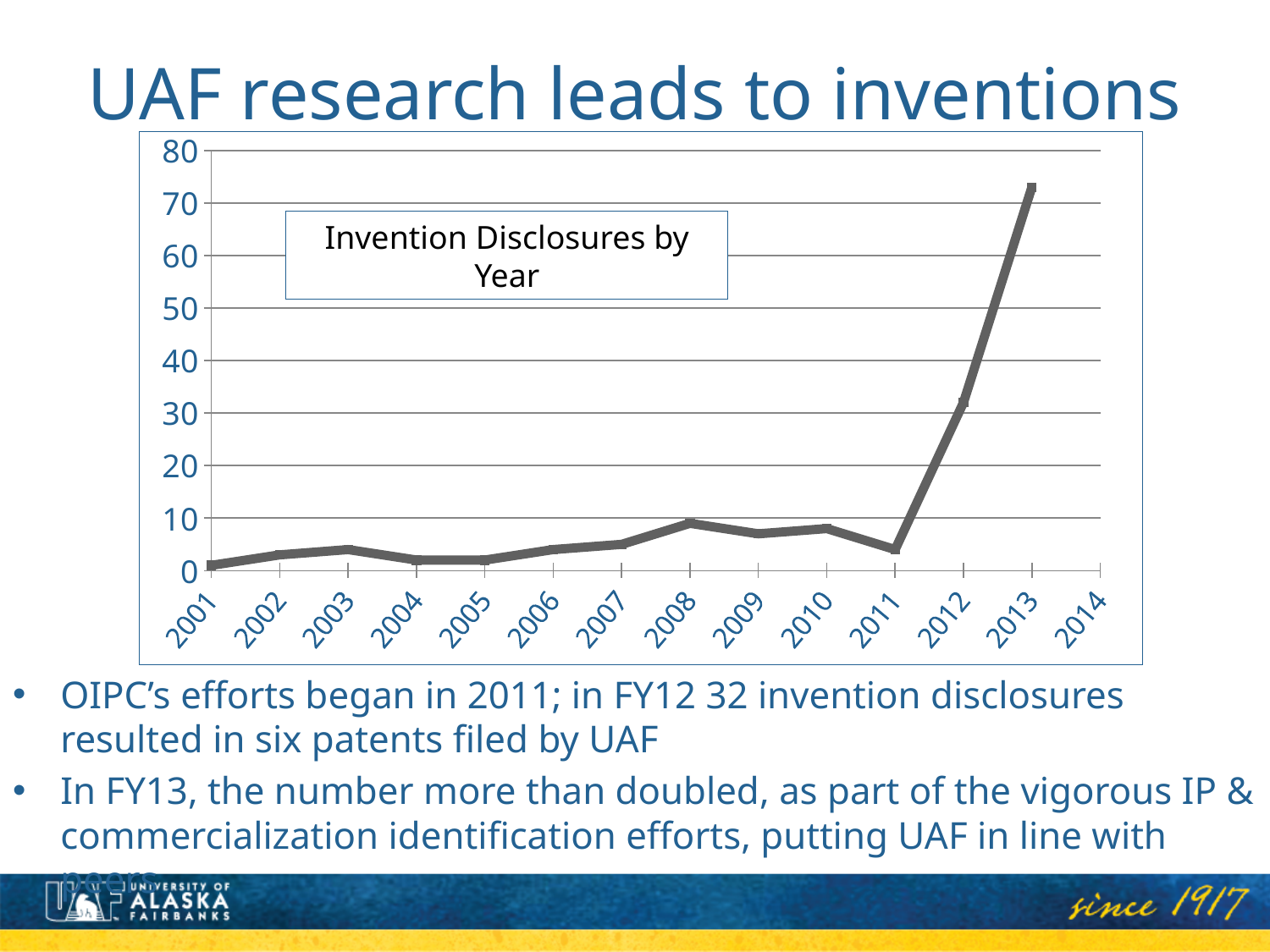
What is the highest value shown on the y axis? 80 Is the value for 2008 greater or less than 20? less Which year has the larger value, 2012 or 2013? 2013 Is the value for 2012 greater or less than 20? greater Is the value for 2013 greater or less than 70? greater What is the title shown inside the chart? Invention Disclosures by Year Which year has the highest number of invention disclosures? 2013 What kind of chart is shown on the slide? line chart How many year labels are shown on the x axis? 14 Do the values rise or fall from 2011 to 2013? rise Which year has the larger value, 2008 or 2011? 2008